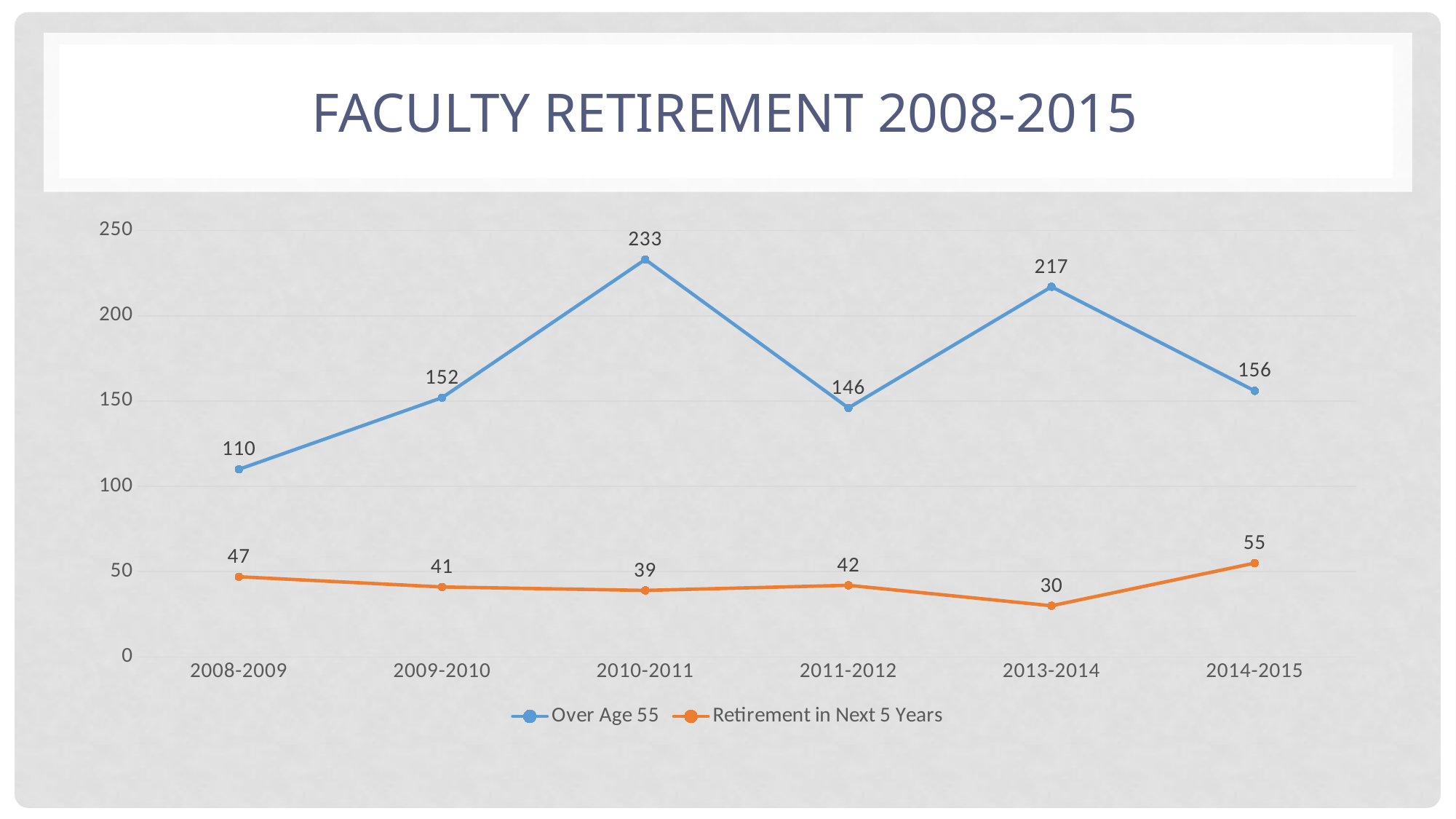
What is the value for Over Age 55 in 2008-2009? 110 How many series does the legend list? 2 How many year categories are shown on the x axis? 6 What kind of chart is shown on the slide? line chart What is the value for Over Age 55 in 2010-2011? 233 What is the difference between the Over Age 55 values for 2013-2014 and 2014-2015? 61 In which year is the Over Age 55 series highest? 2010-2011 What is the title of the chart? FACULTY RETIREMENT 2008-2015 Which is larger, the Retirement in Next 5 Years value for 2008-2009 or for 2011-2012? 2008-2009 In which year is the Retirement in Next 5 Years series lowest? 2013-2014 What is the value for Retirement in Next 5 Years in 2013-2014? 30 Is the value for Over Age 55 in 2011-2012 greater or less than 150? less